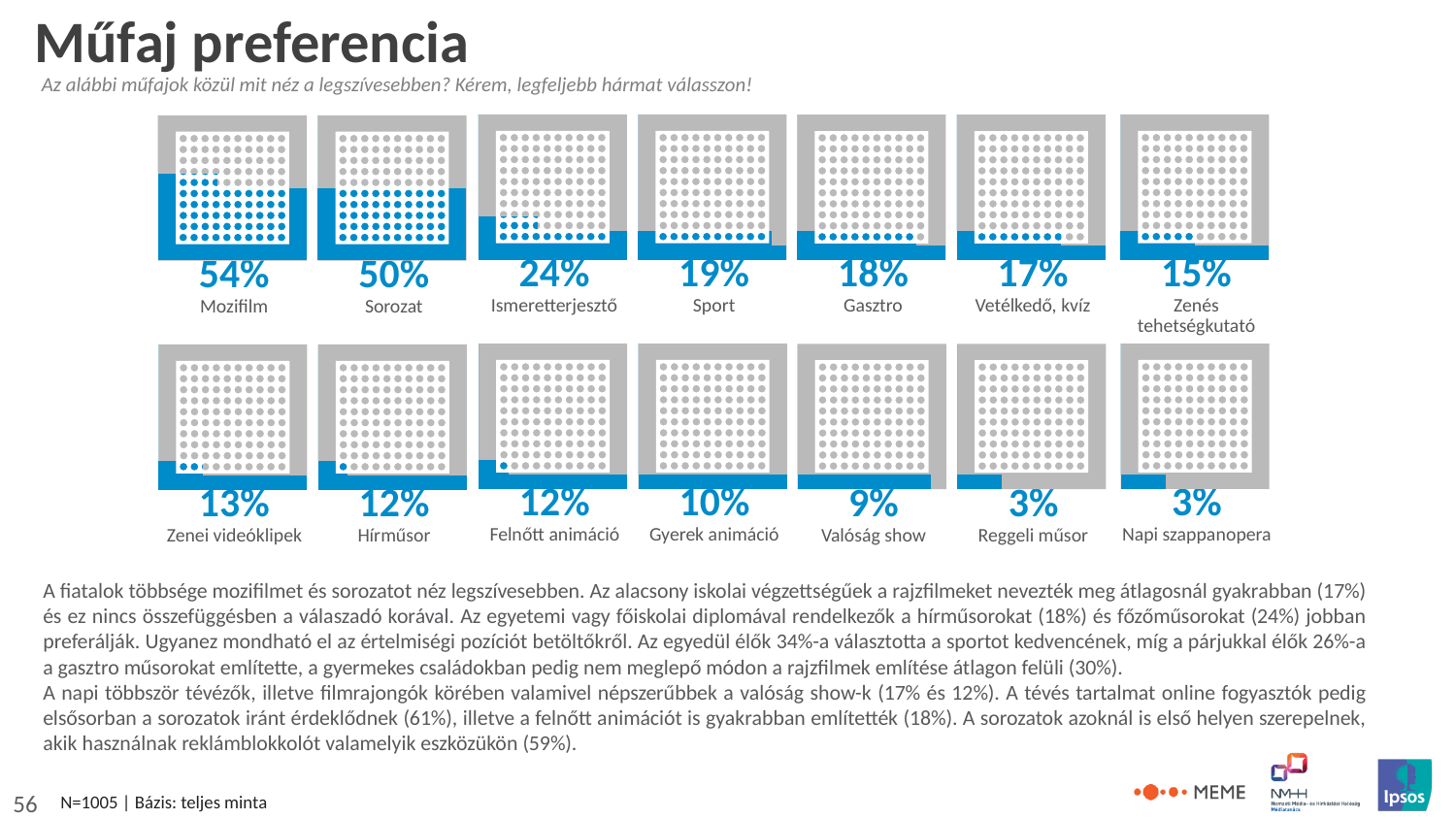
What percentage is shown for Valóság show? 9% How many genre categories are shown on the chart? 14 What is the difference in percentage points between Mozifilm and Sorozat? 4 percentage points Which has a higher percentage, Hírműsor or Zenei videóklipek? Zenei videóklipek What is the difference in percentage points between Sport and Gasztro? 1 percentage point What is the title of the slide containing the chart? Műfaj preferencia What percentage is shown for Gyerek animáció? 10% Which has a higher percentage, Vetélkedő, kvíz or Reggeli műsor? Vetélkedő, kvíz What percentage is shown for Sorozat? 50% What percentage is shown for Ismeretterjesztő? 24% What percentage is shown for Mozifilm? 54% Which genre has the highest percentage? Mozifilm